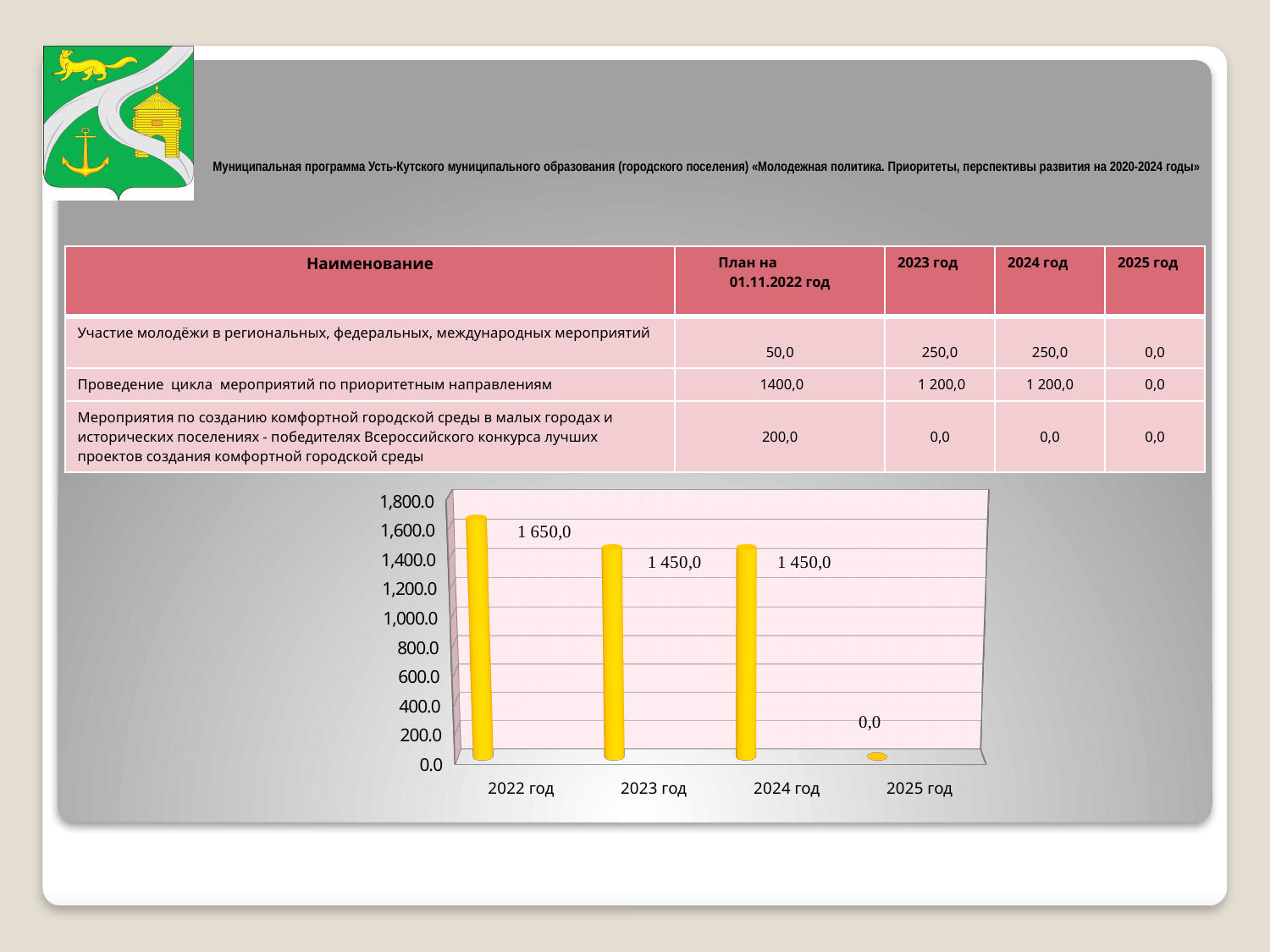
Do the values in the chart rise or fall from 2022 год to 2025 год? fall Which year has the highest value in the chart? 2022 год What colour are the bars in the chart? yellow Which is larger in the chart, the value for 2022 год or the value for 2024 год? 2022 год What is the value shown for 2025 год in the chart? 0,0 What is the difference between the values for 2022 год and 2023 год in the chart? 200,0 How many categories are shown on the x axis of the chart? 4 What is the value shown for 2023 год in the chart? 1 450,0 What kind of chart is shown on the slide? bar chart Which year has the lowest value in the chart? 2025 год Is the value for 2023 год in the chart greater or less than 1,600.0? less What is the value shown for 2022 год in the chart? 1 650,0